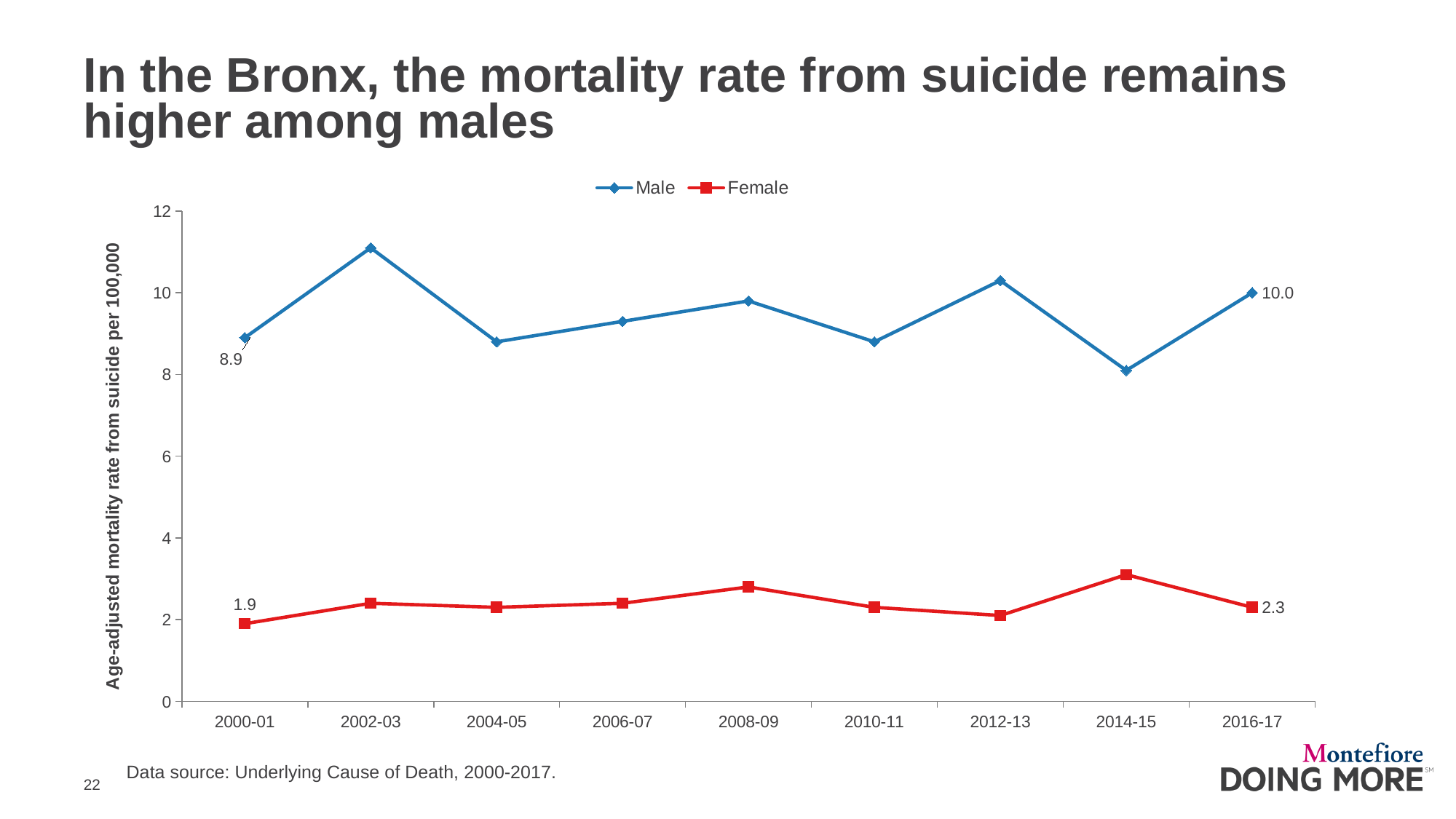
What is the Male rate shown for 2016-17? 10.0 Is the Male value for 2002-03 greater or less than 10? greater What is the Female age-adjusted suicide mortality rate for 2016-17? 2.3 In which period is the Male rate highest? 2002-03 What is the Male age-adjusted suicide mortality rate for 2000-01? 8.9 What kind of chart is shown on the slide? Line chart How many series does the legend list? 2 How many time periods are shown on the x axis? 9 By how much did the Male rate change from 2000-01 (8.9) to 2016-17 (10.0)? 1.1 What is the difference between the Male and Female rates in 2016-17? 7.7 In which period is the Male rate lowest? 2014-15 In which period is the Female rate highest? 2014-15